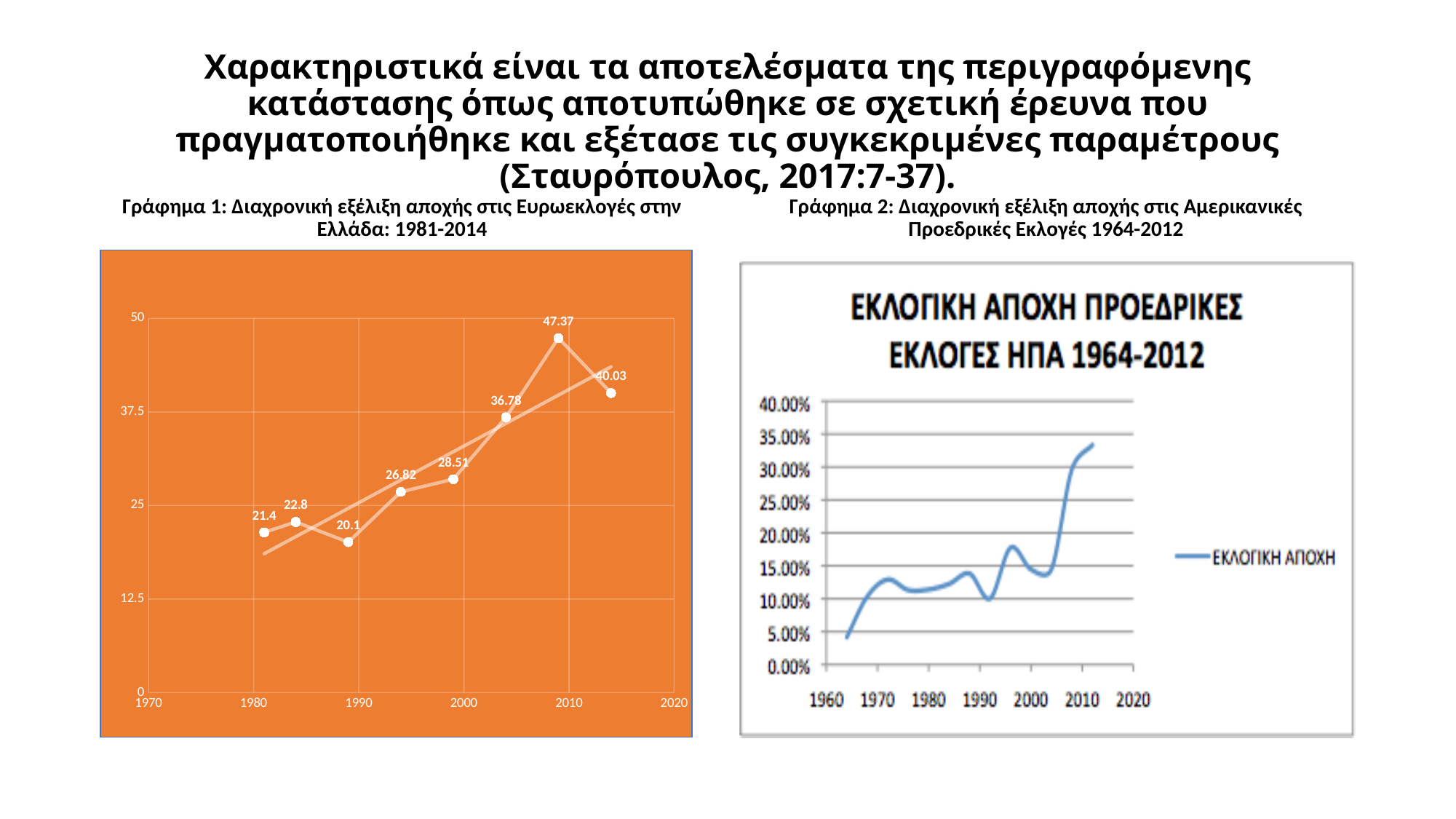
In Γράφημα 1 (the left chart), what is the value of the first data point on the line? 21.4 In Γράφημα 1 (the left chart), how many data points are plotted on the line? 8 In Γράφημα 1 (the left chart), what kind of chart is used to show the data? line chart In Γράφημα 2 (the right chart), what is the name of the series shown in the legend? ΕΚΛΟΓΙΚΗ ΑΠΟΧΗ In Γράφημα 1 (the left chart), what is the lowest value labelled on the line? 20.1 In Γράφημα 2 (the right chart), does the line overall rise or fall from 1964 to 2012? rise In Γράφημα 2 (the right chart), is the value at the end of the line (around 2012) greater or less than 30.00%? greater In Γράφημα 2 (the right chart), how many series does the legend list? 1 In Γράφημα 1 (the left chart), by how much does the value drop from the peak of 47.37 to the final point of 40.03? 7.34 In Γράφημα 1 (the left chart), what is the difference between the highest labelled value (47.37) and the lowest labelled value (20.1)? 27.27 In Γράφημα 1 (the left chart), what is the highest value labelled on the line? 47.37 In Γράφημα 1 (the left chart), what is the value of the last data point on the line? 40.03